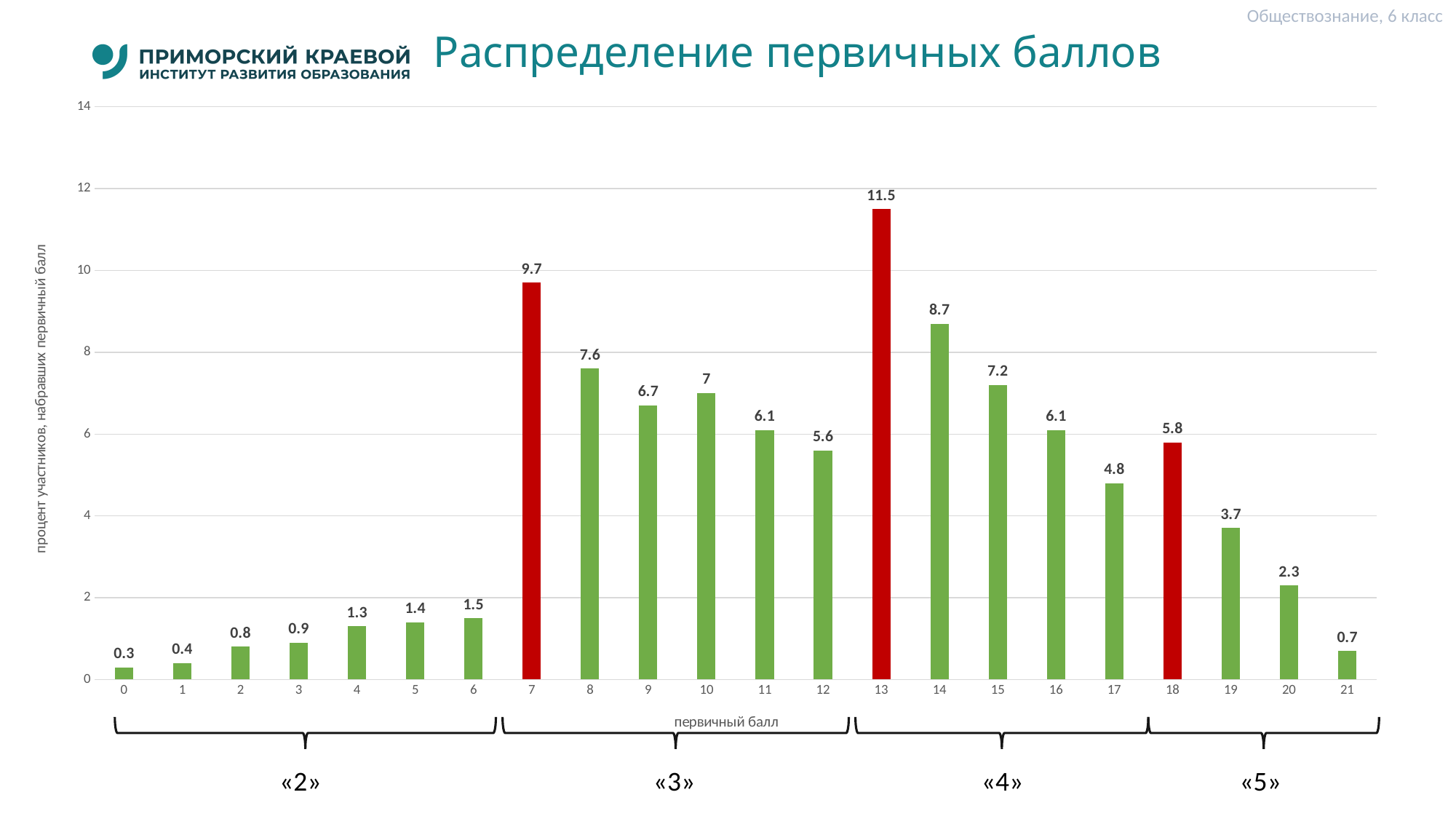
Which primary score has the highest percentage of participants? 13 What is the title of the chart? Распределение первичных баллов How many primary score categories are shown on the x axis? 22 What is the value for primary score 7? 9.7 What is the value for primary score 18? 5.8 Which has a larger value: primary score 14 or primary score 8? 14 Which primary scores are shown with red bars? 7, 13 and 18 Which primary score has the lowest percentage of participants? 0 What is the difference between the values for primary scores 13 and 7? 1.8 Do the values rise or fall along the x axis from primary score 13 to 21? fall What is the value for primary score 13? 11.5 What type of chart is shown on the slide? bar chart